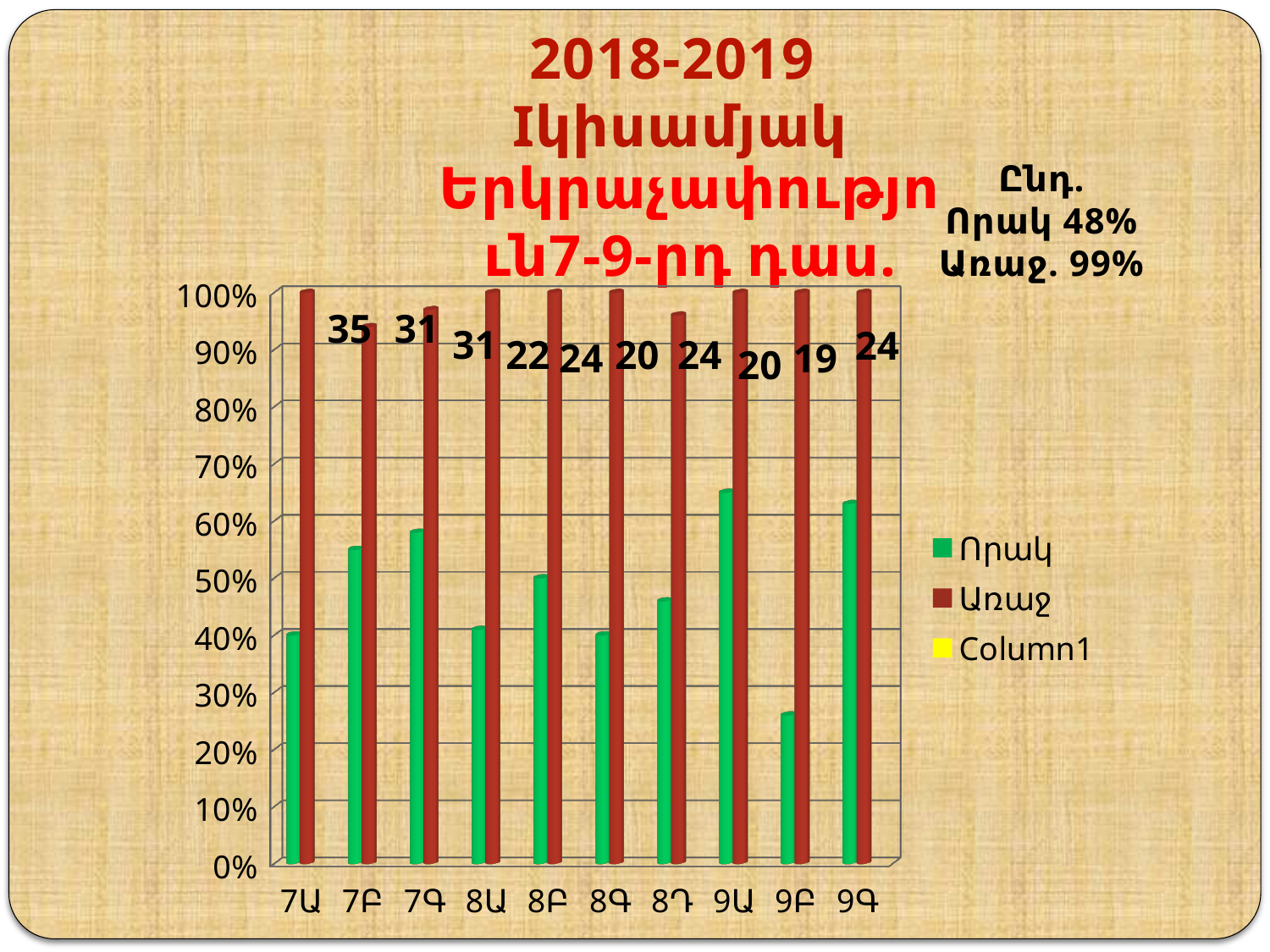
How many series does the chart's legend list? 3 Which class has the larger Որակ value, 7Բ or 9Բ? 7Բ Is the Որակ value for 7Ա greater or less than 50%? less Is the Առաջ value for 7Բ greater or less than 90%? greater Which class has the lowest Որակ value? 9Բ What colour are the bars for the Որակ series? green Is the Որակ value for 9Բ greater or less than 30%? less Which legend entry has no bars plotted in the chart? Column1 Which class has the larger Որակ value, 9Ա or 8Գ? 9Ա What kind of chart is shown on the slide? bar chart How many class categories are shown on the x axis of the chart? 10